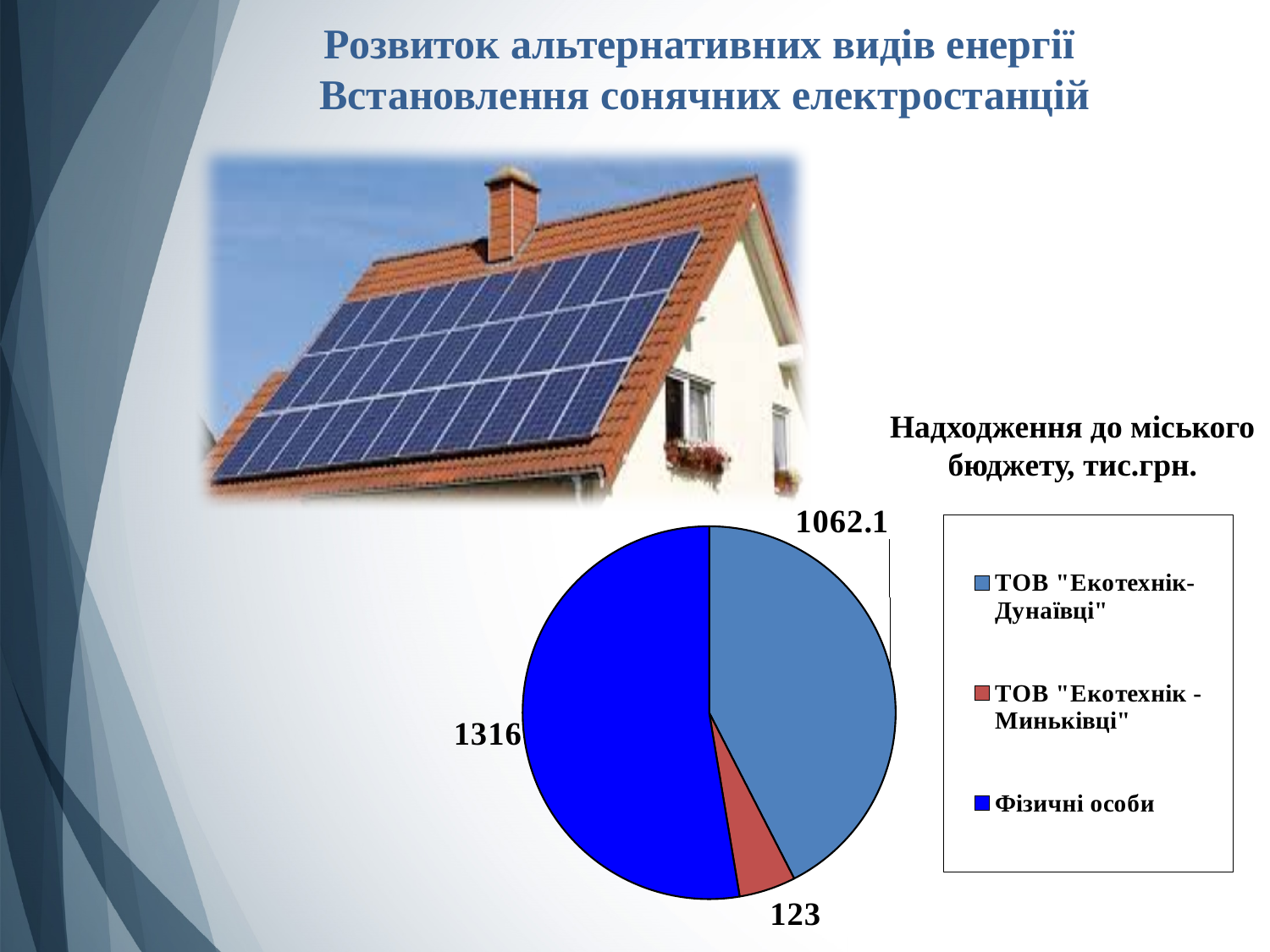
What kind of chart is shown on the slide? Pie chart What is the value for ТОВ "Екотехнік-Дунаївці" in the pie chart? 1062.1 What is the total of all values shown in the pie chart? 2501.1 What is the title of the pie chart? Надходження до міського бюджету, тис.грн. What is the difference between the values for ТОВ "Екотехнік-Дунаївці" and ТОВ "Екотехнік - Миньківці"? 939.1 What is the difference between the values for Фізичні особи and ТОВ "Екотехнік-Дунаївці"? 253.9 Which is larger: the value for Фізичні особи or the value for ТОВ "Екотехнік-Дунаївці"? Фізичні особи What is the value for ТОВ "Екотехнік - Миньківці" in the pie chart? 123 How many slices does the pie chart have? 3 Which category has the largest slice of the pie chart? Фізичні особи What is the value for Фізичні особи in the pie chart? 1316 Which category has the smallest slice of the pie chart? ТОВ "Екотехнік - Миньківці"